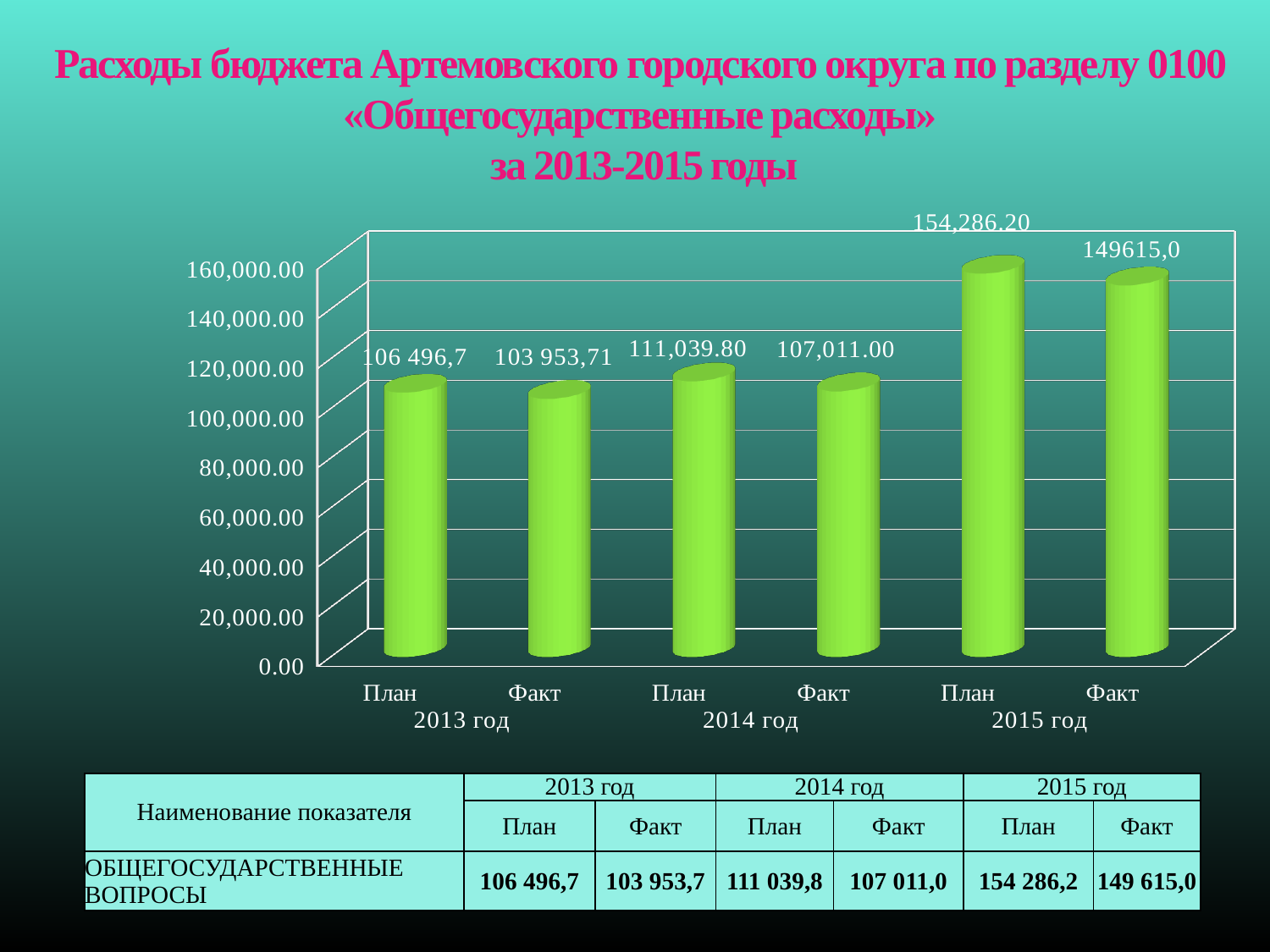
What is the value of the Факт bar for 2013 год? 103 953,71 What is the value of the План bar for 2014 год? 111,039.80 Which bar has the lowest value in the chart? Факт 2013 год Which is larger, the Факт value for 2014 год or the Факт value for 2015 год? Факт 2015 год Which bar has the highest value in the chart? План 2015 год Is the value of the План bar for 2015 год greater or less than 140,000.00? greater What is the value of the План bar for 2013 год? 106 496,7 What is the value of the Факт bar for 2015 год? 149615,0 Do the План values rise or fall from 2013 год to 2015 год? rise What type of chart is shown on the slide? bar chart What is the difference between the План and Факт values for 2014 год? 4,028.80 How many bars are plotted in the chart? 6